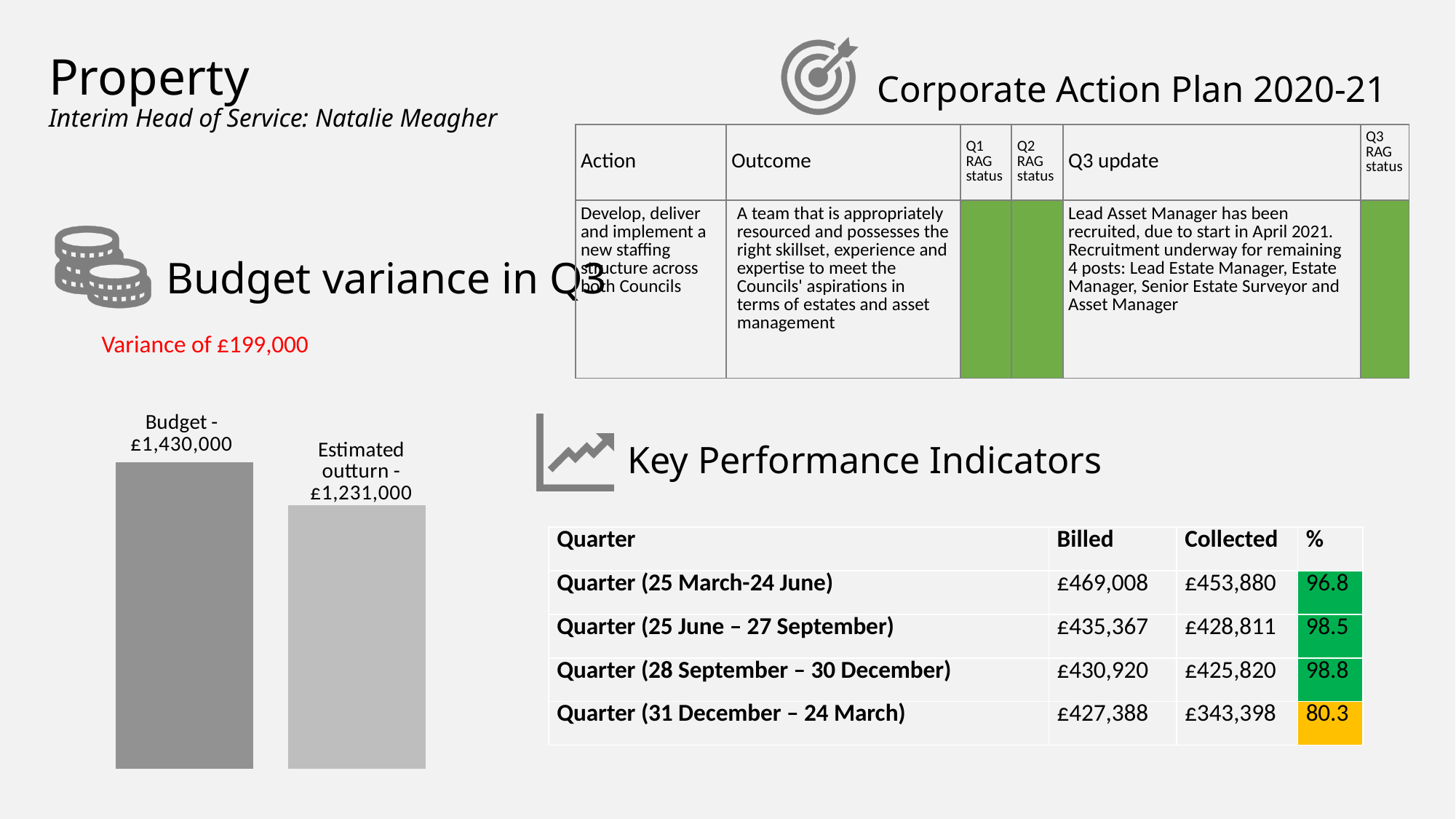
What is the difference between the Budget and the Estimated outturn in the budget variance chart? £199,000 What is the value of the Budget bar in the budget variance chart? £1,430,000 Which bar is taller in the budget variance chart, Budget or Estimated outturn? Budget What kind of chart is shown under 'Budget variance in Q3'? bar chart Which category has the highest value in the budget variance chart? Budget How many bars does the budget variance chart have? 2 Do the values fall or rise from the Budget bar to the Estimated outturn bar in the budget variance chart? fall Which category has the lowest value in the budget variance chart? Estimated outturn What is the title of the section containing the bar chart on the slide? Budget variance in Q3 What variance is stated in red text above the budget variance chart? Variance of £199,000 What is the value of the Estimated outturn bar in the budget variance chart? £1,231,000